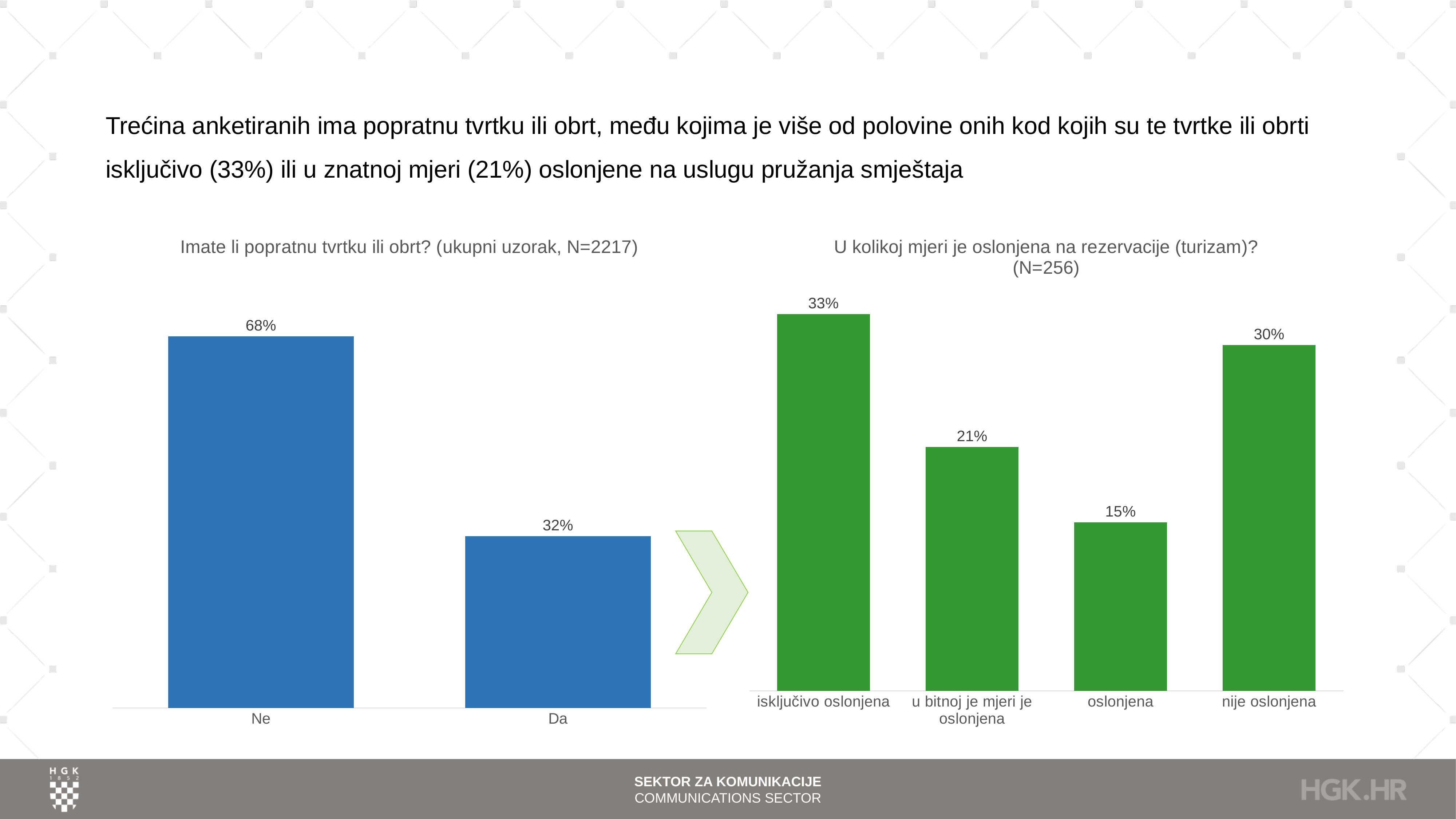
In the right chart 'U kolikoj mjeri je oslonjena na rezervacije (turizam)?', what is the value for 'isključivo oslonjena'? 33% In the right chart 'U kolikoj mjeri je oslonjena na rezervacije (turizam)?', which category has the lowest value? oslonjena In the left chart 'Imate li popratnu tvrtku ili obrt?', what is the value for 'Ne'? 68% What type of chart is the left chart 'Imate li popratnu tvrtku ili obrt?'? bar chart In the left chart 'Imate li popratnu tvrtku ili obrt?', what is the value for 'Da'? 32% In the right chart 'U kolikoj mjeri je oslonjena na rezervacije (turizam)?', what is the value for 'nije oslonjena'? 30% In the left chart 'Imate li popratnu tvrtku ili obrt?', how many categories are shown? 2 In the right chart 'U kolikoj mjeri je oslonjena na rezervacije (turizam)?', which category has the highest value? isključivo oslonjena In the right chart 'U kolikoj mjeri je oslonjena na rezervacije (turizam)?', what is the difference between 'u bitnoj je mjeri je oslonjena' and 'oslonjena'? 6% In the left chart 'Imate li popratnu tvrtku ili obrt?', what is the difference between 'Ne' and 'Da'? 36% In the right chart 'U kolikoj mjeri je oslonjena na rezervacije (turizam)?', which is larger: 'u bitnoj je mjeri je oslonjena' or 'nije oslonjena'? nije oslonjena In the right chart 'U kolikoj mjeri je oslonjena na rezervacije (turizam)?', how many categories are shown? 4